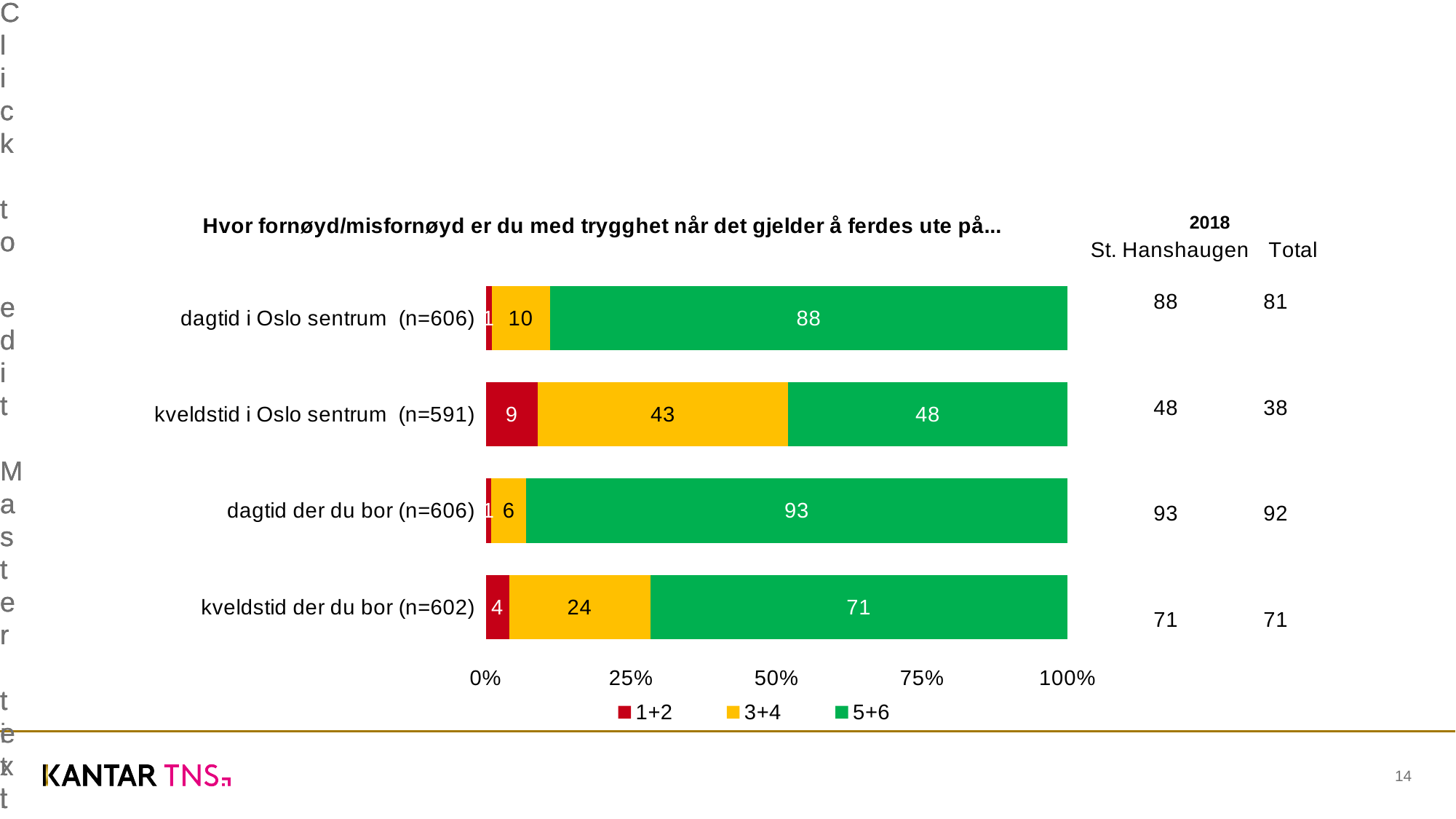
Which category has the highest value for the 5+6 series? dagtid der du bor (n=606) Which category has the lowest value for the 5+6 series? kveldstid i Oslo sentrum (n=591) Which is larger: the 3+4 value for "kveldstid i Oslo sentrum (n=591)" or the 3+4 value for "kveldstid der du bor (n=602)"? kveldstid i Oslo sentrum (n=591) What kind of chart is shown on the slide? Stacked bar chart What is the difference between the 5+6 values for "dagtid der du bor (n=606)" and "kveldstid der du bor (n=602)"? 22 Which colour represents the 5+6 series in the legend? Green How many series does the legend list? 3 How many categories are shown on the chart? 4 What is the value of the 5+6 series for "dagtid i Oslo sentrum (n=606)"? 88 What is the value of the 1+2 series for "kveldstid der du bor (n=602)"? 4 What is the total of the stacked bar for "kveldstid i Oslo sentrum (n=591)"? 100 What is the value of the 3+4 series for "kveldstid i Oslo sentrum (n=591)"? 43